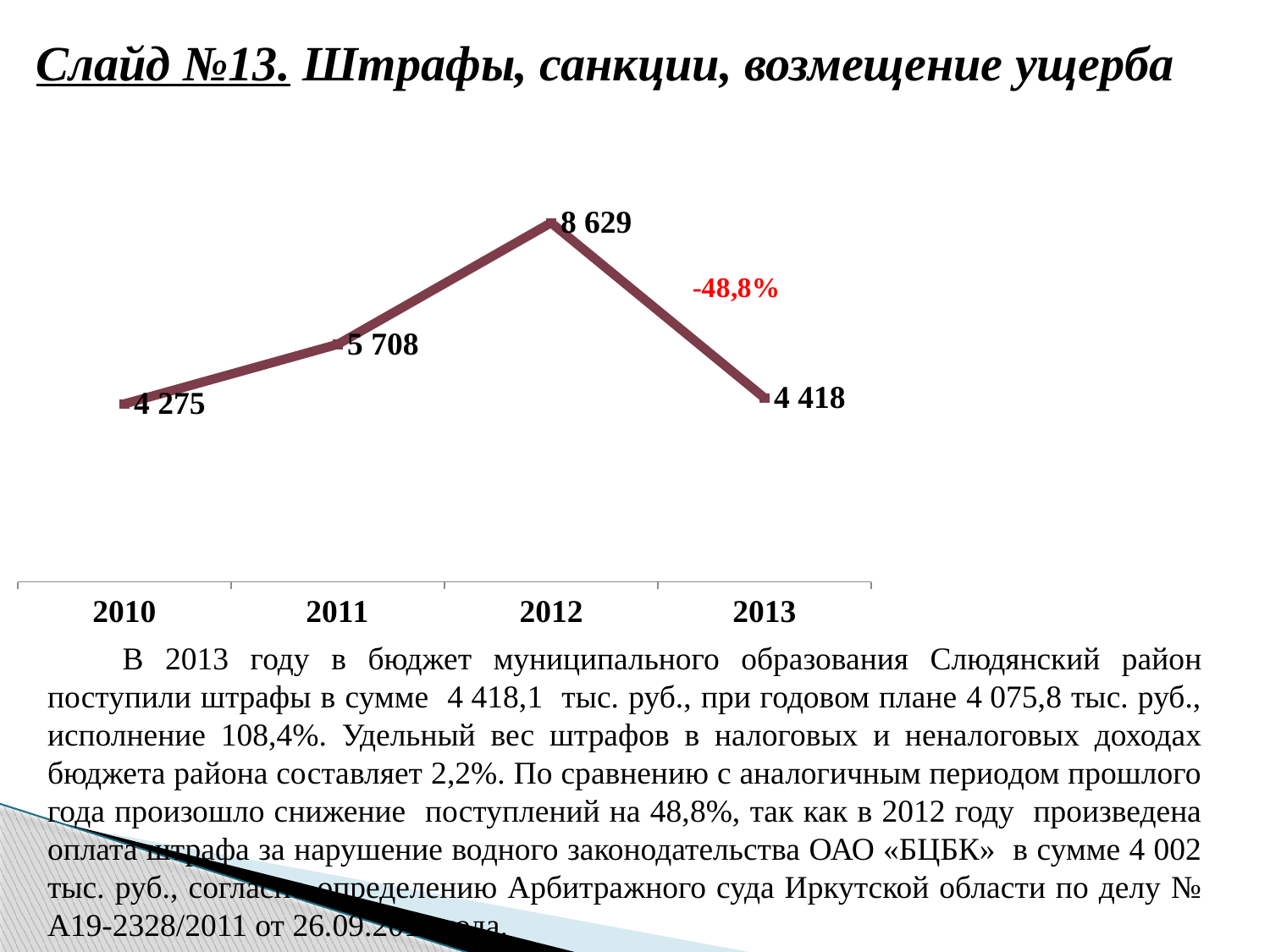
What is the difference between the values for 2012 and 2013? 4 211 What percentage change is annotated on the chart between 2012 and 2013? -48,8% What is the difference between the values for 2011 and 2010? 1 433 What type of chart is shown on the slide? line chart How many years are plotted on the chart? 4 What is the value for 2013? 4 418 What is the value for 2011? 5 708 What is the value for 2012? 8 629 Which year has the lowest value? 2010 Which is larger, the value for 2011 or the value for 2013? 2011 Which year has the highest value? 2012 What is the value for 2010? 4 275